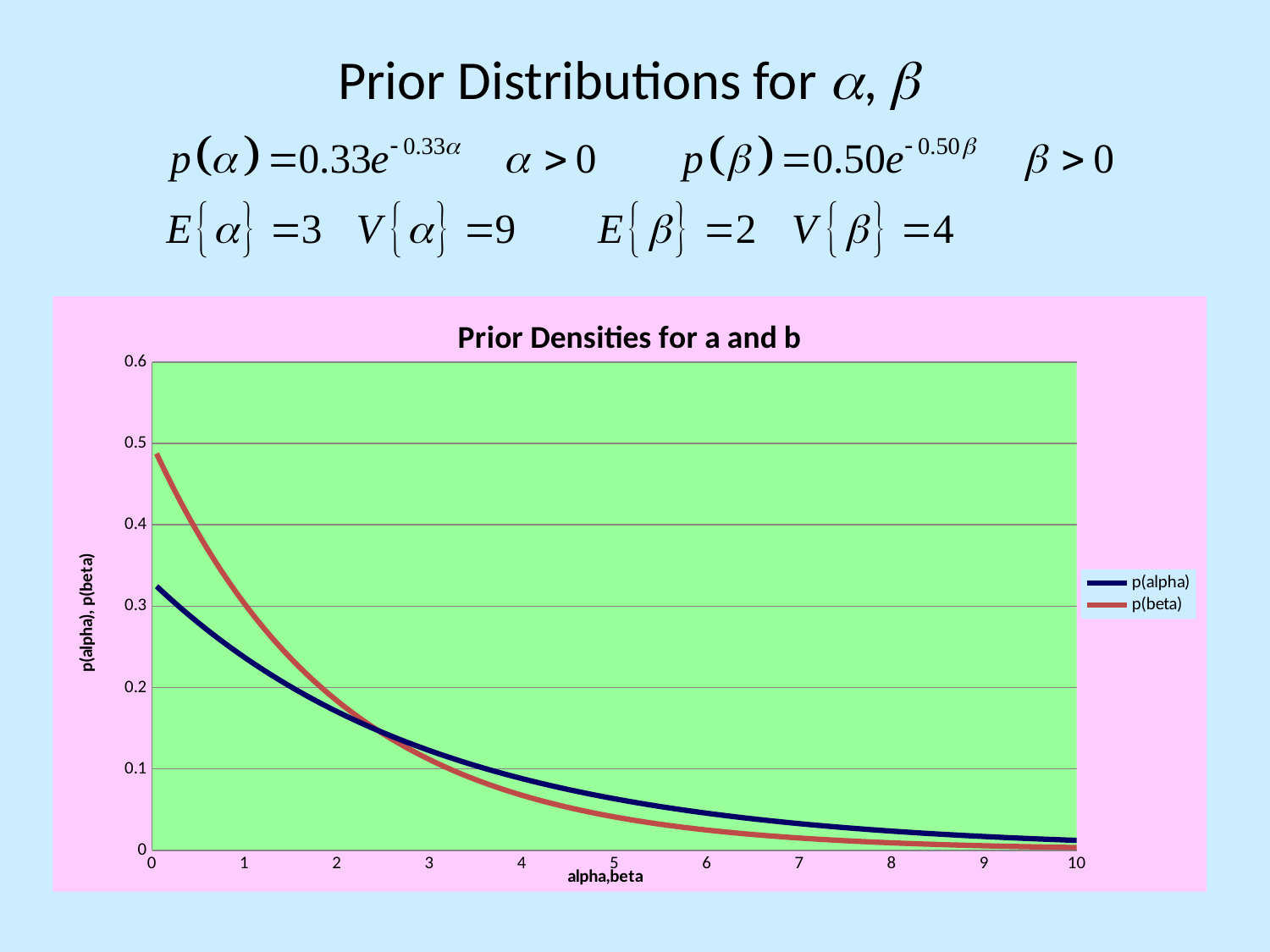
Which series has the higher value at x = 1, p(alpha) or p(beta)? p(beta) Do the values of the p(beta) series rise or fall along the x axis? fall Is the value of p(alpha) at x = 5 greater or less than 0.1? less Do the values of the p(alpha) series rise or fall as alpha increases along the x axis? fall What kind of chart is shown on the slide? line chart Which series starts at the higher value at the left edge of the chart? p(beta) Which series has the higher value at x = 5, p(alpha) or p(beta)? p(alpha) What is the label of the x axis of the chart? alpha,beta What is the title of the chart? Prior Densities for a and b Is the value of p(alpha) at x = 1 greater or less than 0.2? greater How many series does the legend of the chart list? 2 Is the value of p(beta) at x = 4 greater or less than 0.1? less